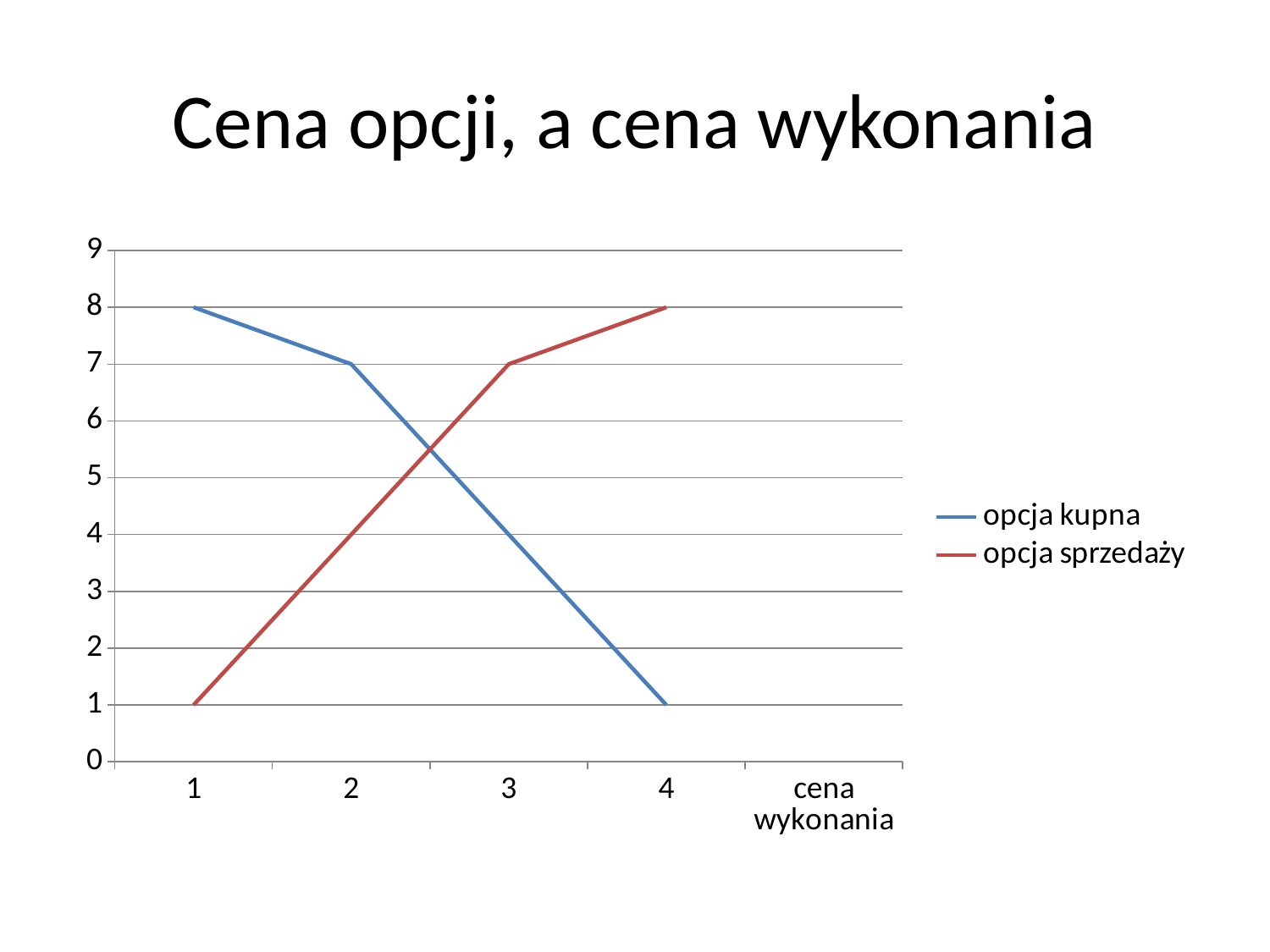
Does the opcja sprzedaży line rise or fall as cena wykonania increases? rise What is the value of opcja sprzedaży at cena wykonania 1? 1 Does the opcja kupna line rise or fall as cena wykonania increases? fall What is the value of opcja sprzedaży at cena wykonania 4? 8 What is the value of opcja kupna at cena wykonania 1? 8 What kind of chart is shown on the slide? line chart At cena wykonania 3, which series has the higher value, opcja kupna or opcja sprzedaży? opcja sprzedaży How many series does the legend list? 2 What is the difference between the opcja kupna value at cena wykonania 1 and at cena wykonania 4? 7 What is the value of opcja kupna at cena wykonania 4? 1 Is the value of opcja sprzedaży at cena wykonania 2 greater or less than 5? less At cena wykonania 2, which series has the higher value, opcja kupna or opcja sprzedaży? opcja kupna